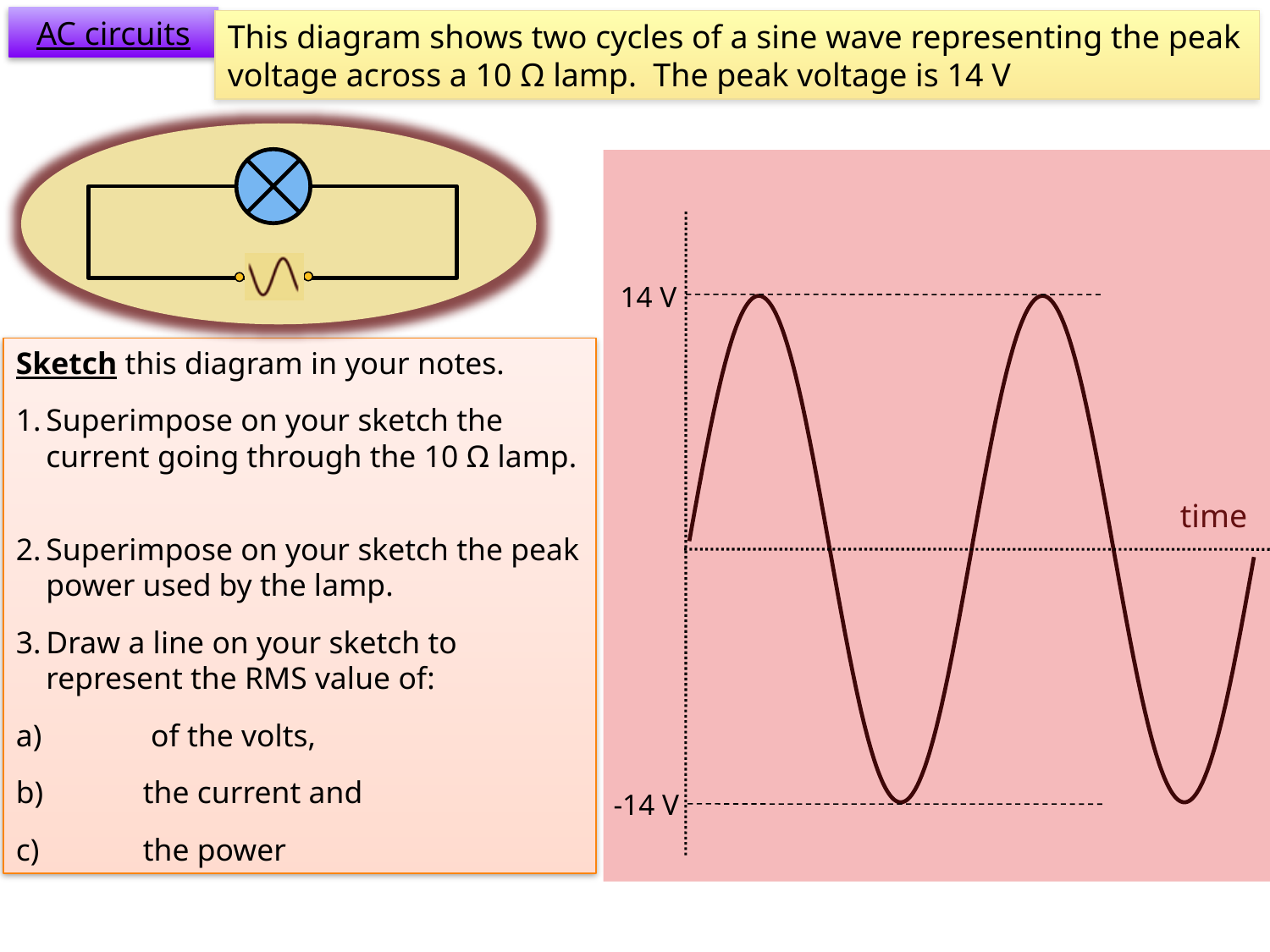
What is the label on the horizontal axis of the graph? time What colour is the sine wave line on the graph? dark red How many peaks does the sine wave reach at 14 V on the graph? 2 Does the sine wave initially rise or fall from the origin as time increases? rise What is the minimum voltage value marked on the sine wave graph? -14 V What is the difference between the highest and lowest voltage values marked on the graph? 28 V What is the peak voltage across the lamp according to the graph? 14 V What kind of chart is shown on the right of the slide? line chart What is the maximum voltage value marked on the sine wave graph? 14 V How many complete cycles of the sine wave are shown on the graph? 2 Which is larger in magnitude on the graph: the peak voltage or the trough voltage? they are equal